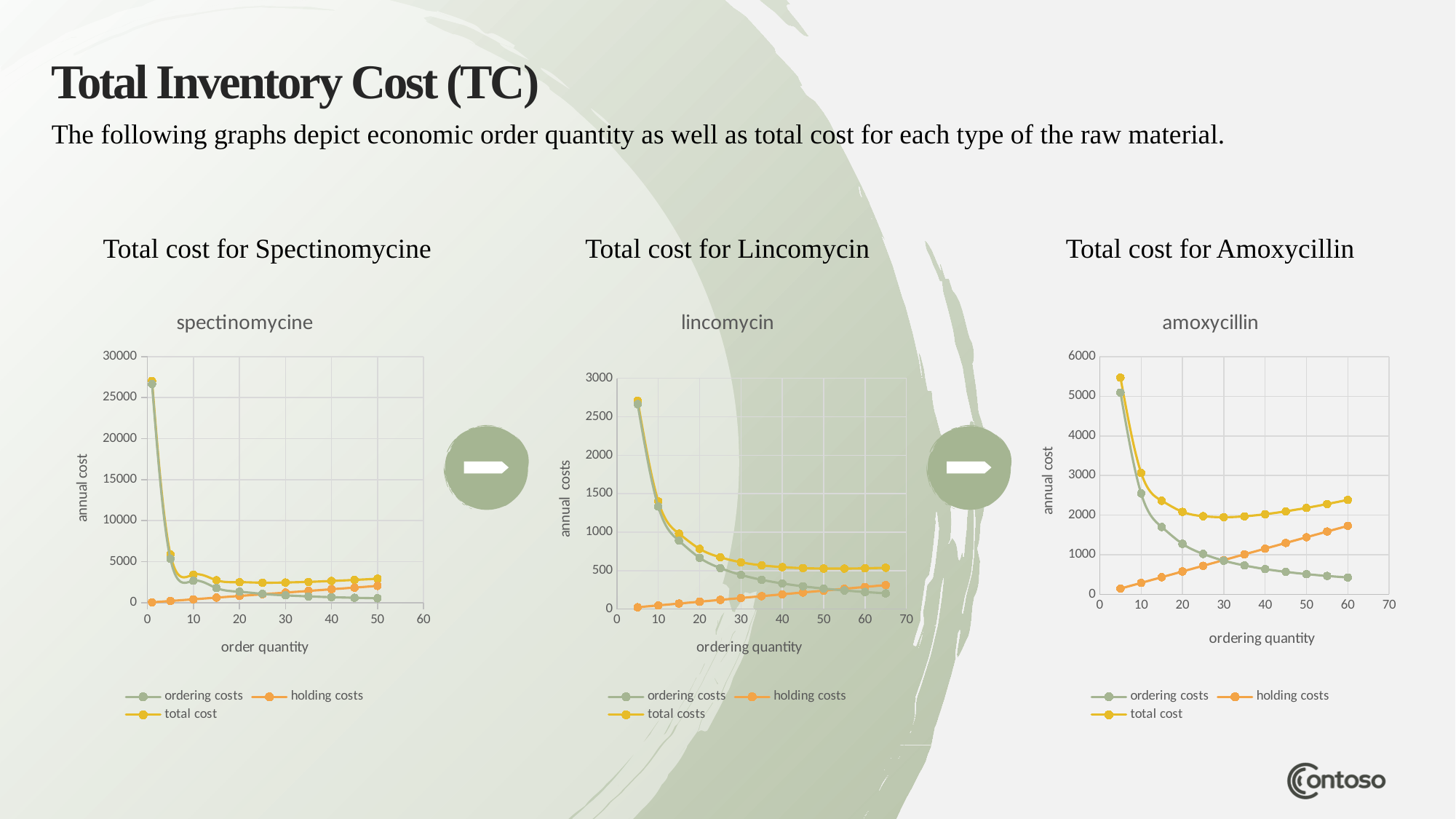
What is the x-axis label of the amoxycillin chart? ordering quantity In the lincomycin chart, is the ordering costs value at ordering quantity 5 greater or less than 2500? greater In the lincomycin chart, do the ordering costs rise or fall as ordering quantity increases? fall In the amoxycillin chart, is the total cost value at ordering quantity 5 greater or less than 5000? greater In the lincomycin chart, is the holding costs value at ordering quantity 65 greater or less than 500? less What kind of chart is the spectinomycine chart? line chart In the amoxycillin chart, at ordering quantity 60, which is larger: holding costs or ordering costs? holding costs In the amoxycillin chart, do the holding costs rise or fall as ordering quantity increases? rise How many series does the legend of the lincomycin chart list? 3